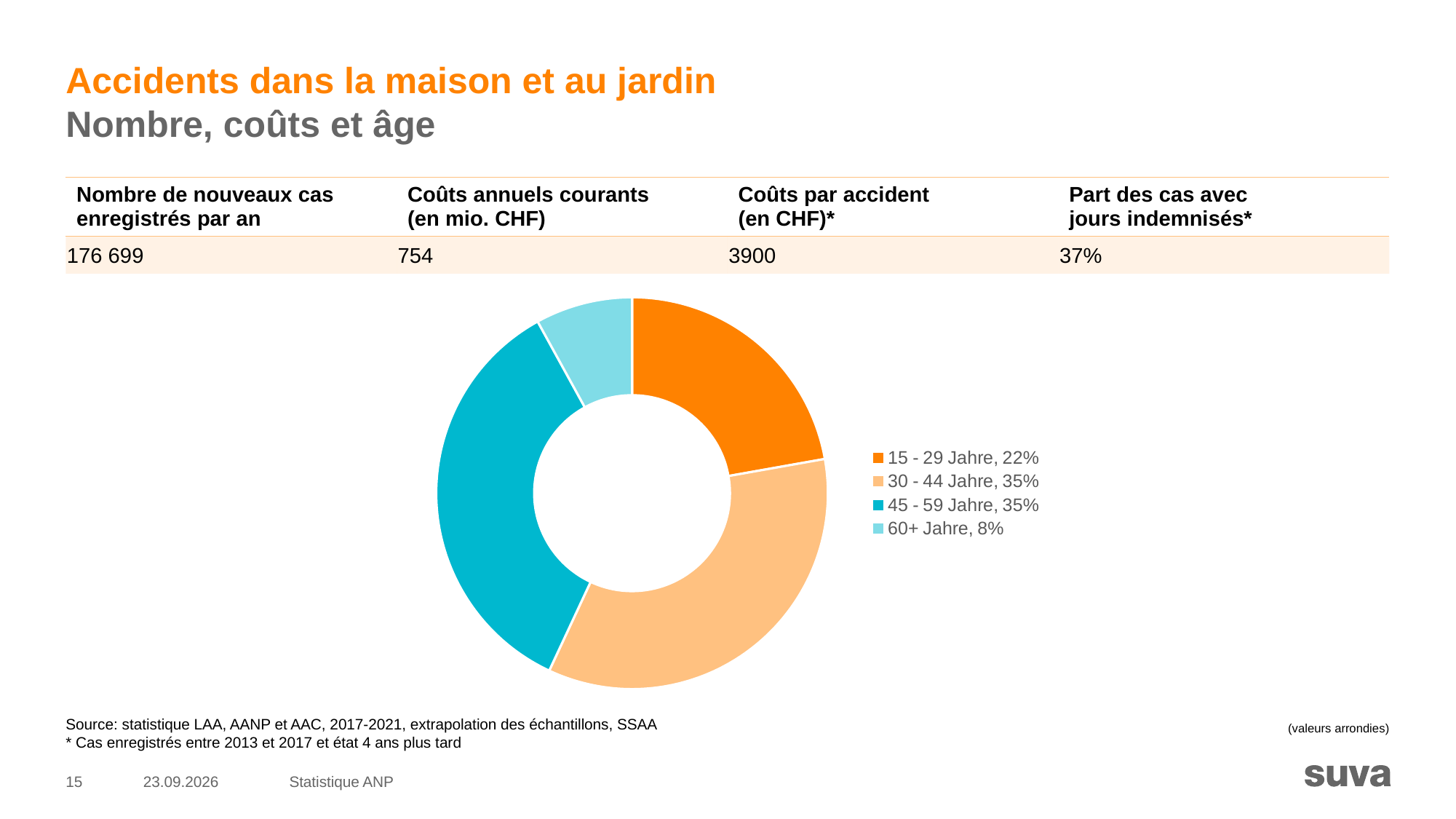
What is the difference in percentage points between the 30 - 44 Jahre share and the 15 - 29 Jahre share? 13 Which age group has the smallest share in the doughnut chart? 60+ Jahre What is the combined share of the 30 - 44 Jahre and 45 - 59 Jahre slices? 70% Which colour represents the 45 - 59 Jahre slice in the chart? Teal (dark cyan) What is the value shown for 45 - 59 Jahre in the chart legend? 35% What share of the doughnut chart is the 60+ Jahre slice? 8% How many age groups are shown in the doughnut chart? 4 What share of the doughnut chart is the 15 - 29 Jahre slice? 22% Which is larger, the share for 15 - 29 Jahre or the share for 60+ Jahre? 15 - 29 Jahre What is the value shown for 30 - 44 Jahre in the chart legend? 35% What is the difference in percentage points between the 15 - 29 Jahre share and the 60+ Jahre share? 14 What kind of chart is shown on the slide? Doughnut chart